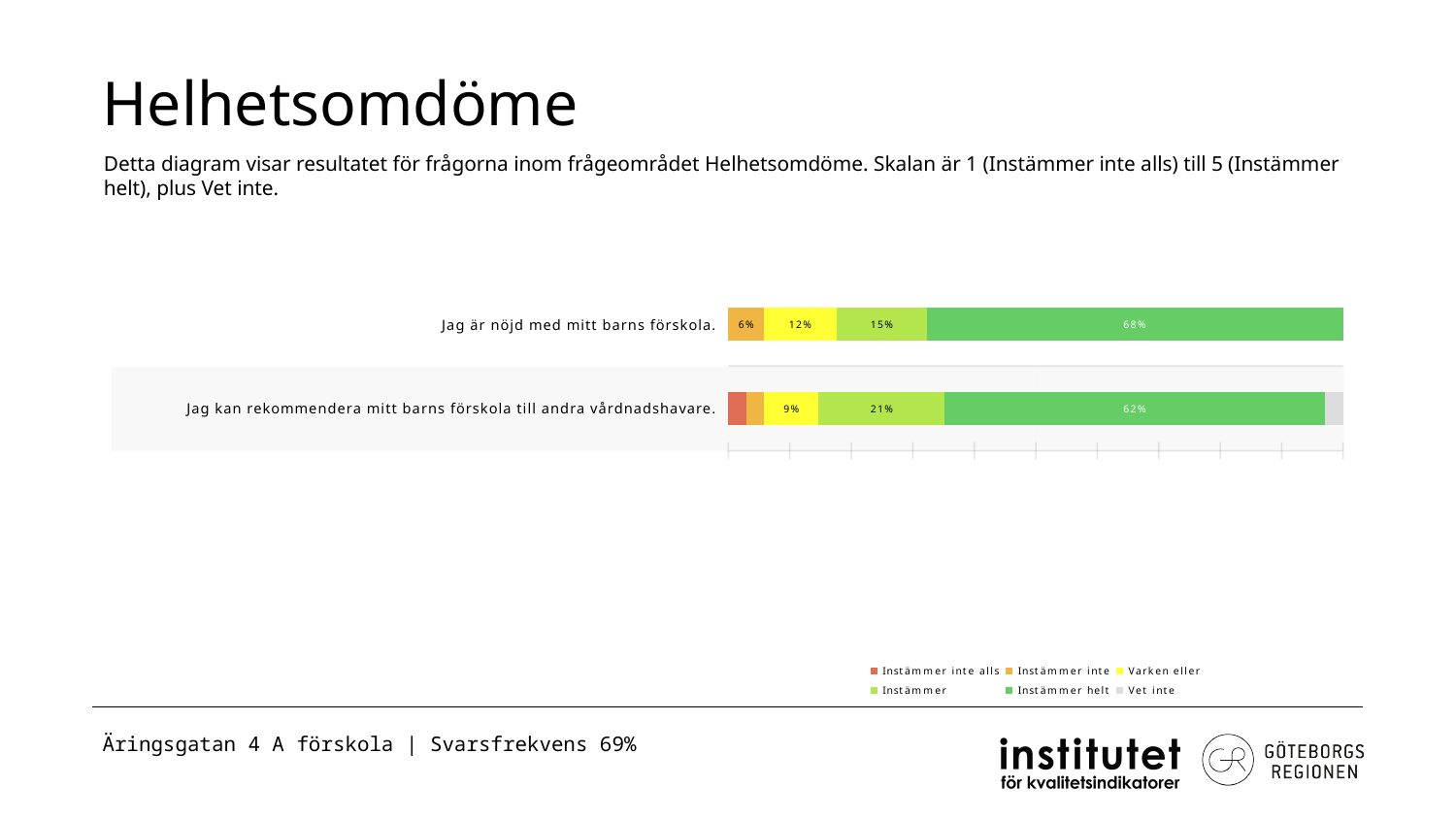
What kind of chart is shown on the slide? Stacked bar chart What is the "Instämmer" share for "Jag kan rekommendera mitt barns förskola till andra vårdnadshavare."? 21% What is the difference in the "Instämmer helt" share between "Jag är nöjd med mitt barns förskola." and "Jag kan rekommendera mitt barns förskola till andra vårdnadshavare."? 6 percentage points What is the "Varken eller" share for "Jag kan rekommendera mitt barns förskola till andra vårdnadshavare."? 9% Which response category has the largest share for "Jag kan rekommendera mitt barns förskola till andra vårdnadshavare."? Instämmer helt Which statement has the higher "Instämmer helt" share? Jag är nöjd med mitt barns förskola. How many statements (categories) are shown in the chart? 2 How many response categories does the legend list? 6 What is the "Varken eller" share for "Jag är nöjd med mitt barns förskola."? 12% What percentage of respondents answered "Instämmer helt" for "Jag kan rekommendera mitt barns förskola till andra vårdnadshavare."? 62% What is the difference in the "Instämmer" share between the two statements? 6 percentage points What percentage of respondents answered "Instämmer helt" for "Jag är nöjd med mitt barns förskola."? 68%